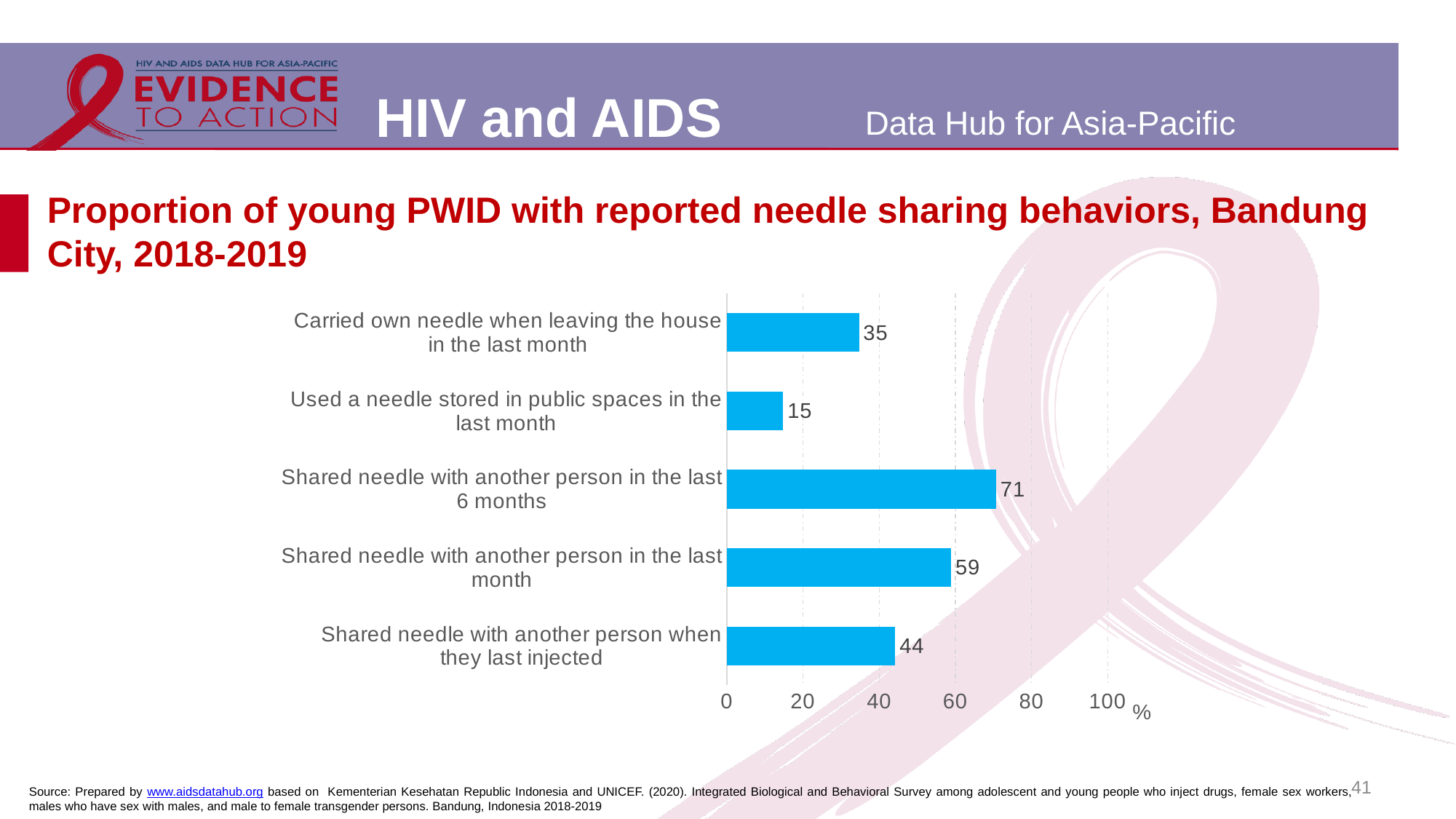
What unit is shown on the x axis of the chart? % How many categories are shown in the chart? 5 What is the value for 'Shared needle with another person in the last 6 months'? 71 What is the value for 'Used a needle stored in public spaces in the last month'? 15 Which category has the lowest value? Used a needle stored in public spaces in the last month What is the difference between the values for 'Shared needle with another person in the last 6 months' and 'Shared needle with another person in the last month'? 12 What is the value for 'Shared needle with another person when they last injected'? 44 Which is larger: the value for 'Shared needle with another person when they last injected' or 'Carried own needle when leaving the house in the last month'? Shared needle with another person when they last injected Is the value for 'Shared needle with another person in the last month' greater or less than 40? greater What is the value for 'Carried own needle when leaving the house in the last month'? 35 Which category has the highest value? Shared needle with another person in the last 6 months What kind of chart is shown on the slide? Bar chart